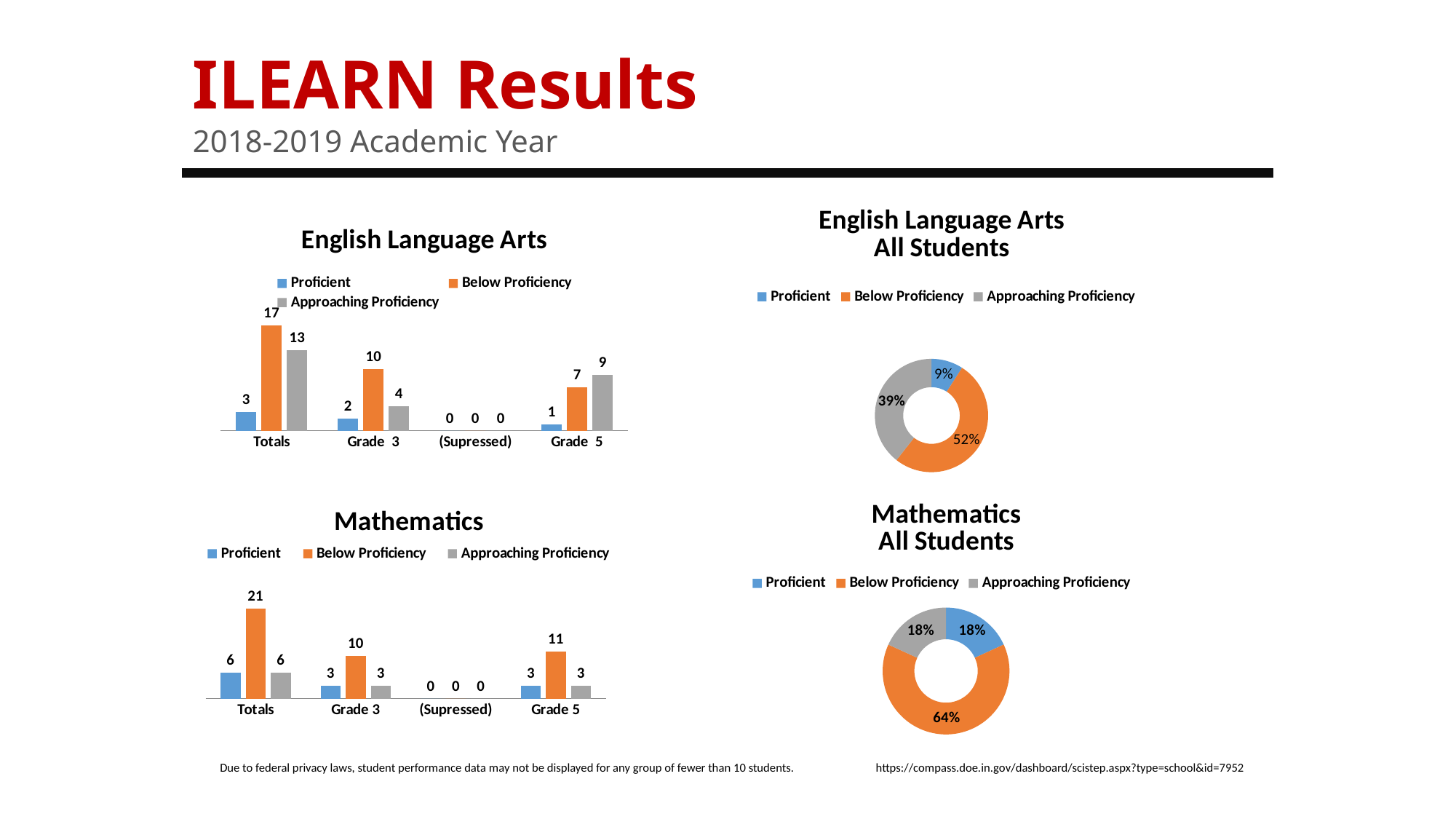
In the Mathematics All Students chart, what share is Proficient? 18% How many categories are shown on the x axis of the English Language Arts bar chart? 4 In the Mathematics bar chart, what is the Proficient value for Grade 3? 3 In the English Language Arts bar chart, what is the Below Proficiency value for Totals? 17 In the English Language Arts bar chart, what is the Approaching Proficiency value for Grade 5? 9 In the Mathematics bar chart, which is larger for Grade 5: Below Proficiency or Approaching Proficiency? Below Proficiency In the English Language Arts bar chart, what is the difference between the Below Proficiency and Proficient values for Totals? 14 In the Mathematics bar chart, which category has the highest Below Proficiency value? Totals In the English Language Arts All Students chart, what share is Below Proficiency? 52% What kind of chart is the English Language Arts All Students chart? Doughnut chart In the Mathematics bar chart, what is the Below Proficiency value for Totals? 21 How many series does the legend of the Mathematics bar chart list? 3